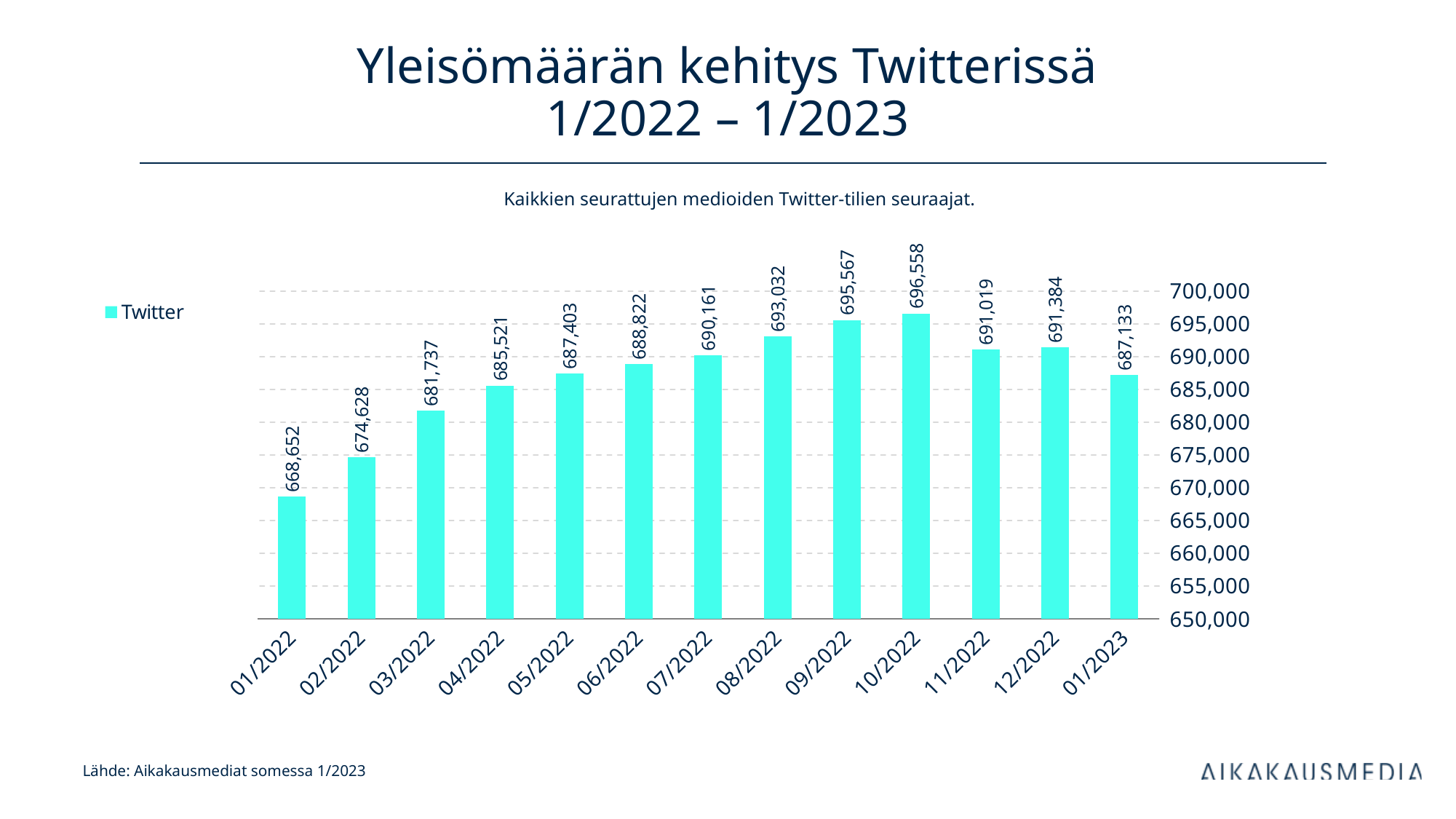
Which month has the highest value? 10/2022 What is the value for 01/2022? 668,652 What is the value for 01/2023? 687,133 What is the difference between the values for 10/2022 and 01/2022? 27,906 Which month has the lowest value? 01/2022 How many series does the legend list? 1 Is the value for 09/2022 greater or less than 695,000? greater What kind of chart is shown? bar chart What is the value for 10/2022? 696,558 How many months are shown on the x axis? 13 Do the values rise or fall from 01/2022 to 10/2022? rise Which is larger, the value for 11/2022 or the value for 12/2022? 12/2022